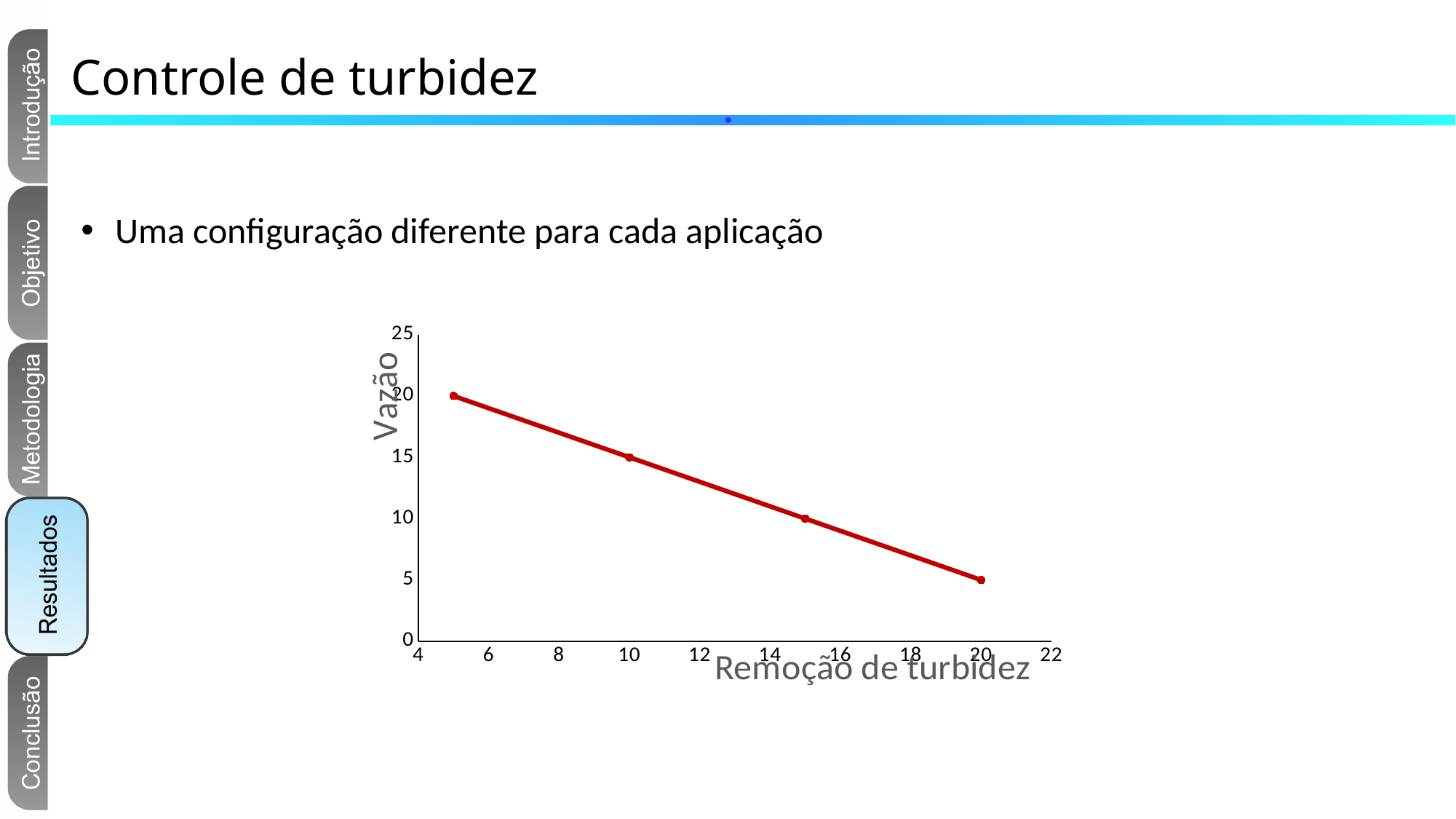
What is the Vazão value at Remoção de turbidez 10? 15 What is the highest Vazão value plotted on the chart? 20 Does Vazão rise or fall as Remoção de turbidez increases? fall What is the title of the vertical axis? Vazão How many data points are plotted on the line? 4 What is the Vazão value at Remoção de turbidez 20? 5 Is the Vazão value of the leftmost point greater or less than 15? greater What kind of chart is shown on the slide? line chart What is the difference between the Vazão at Remoção de turbidez 10 and at Remoção de turbidez 20? 10 What is the title of the horizontal axis? Remoção de turbidez Which has the larger Vazão: Remoção de turbidez 10 or Remoção de turbidez 20? Remoção de turbidez 10 What is the lowest Vazão value plotted on the chart? 5